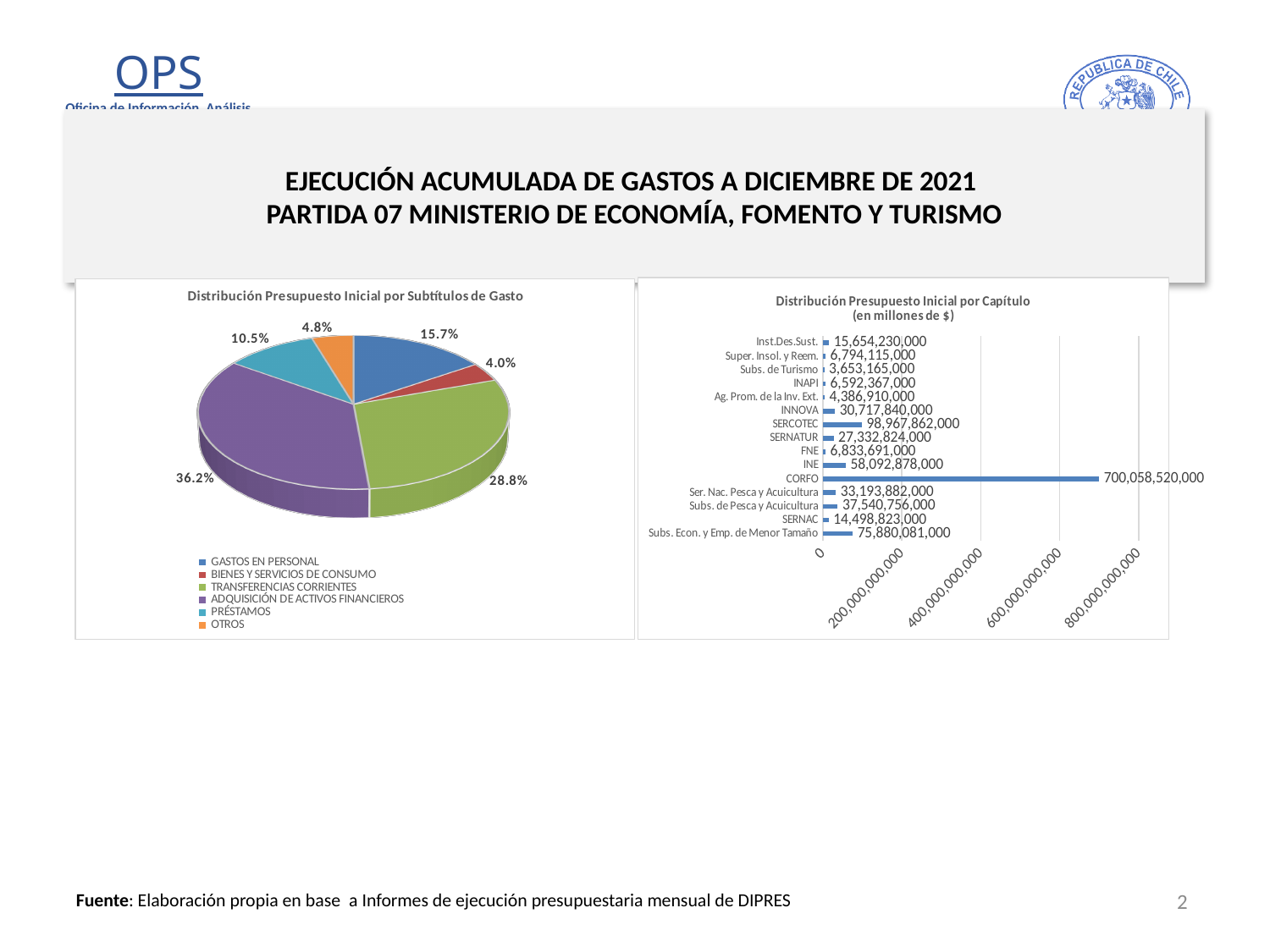
In the bar chart 'Distribución Presupuesto Inicial por Capítulo', which is larger, the value for INE or the value for SERNATUR? INE In the bar chart 'Distribución Presupuesto Inicial por Capítulo', what is the value for SERCOTEC? 98,967,862,000 In the pie chart 'Distribución Presupuesto Inicial por Subtítulos de Gasto', which category has the smallest share? BIENES Y SERVICIOS DE CONSUMO What kind of chart is 'Distribución Presupuesto Inicial por Capítulo'? Bar chart In the pie chart 'Distribución Presupuesto Inicial por Subtítulos de Gasto', what is the difference between the shares of GASTOS EN PERSONAL and PRÉSTAMOS? 5.2% In the pie chart 'Distribución Presupuesto Inicial por Subtítulos de Gasto', which category has the largest share? ADQUISICIÓN DE ACTIVOS FINANCIEROS In the pie chart 'Distribución Presupuesto Inicial por Subtítulos de Gasto', how many categories does the legend list? 6 In the bar chart 'Distribución Presupuesto Inicial por Capítulo', is the value for CORFO greater or less than 600,000,000,000? greater In the bar chart 'Distribución Presupuesto Inicial por Capítulo', which capítulo has the lowest value? Subs. de Turismo In the bar chart 'Distribución Presupuesto Inicial por Capítulo', what is the value for CORFO? 700,058,520,000 In the bar chart 'Distribución Presupuesto Inicial por Capítulo', how many capítulos are plotted? 15 In the pie chart 'Distribución Presupuesto Inicial por Subtítulos de Gasto', what share does TRANSFERENCIAS CORRIENTES have? 28.8%